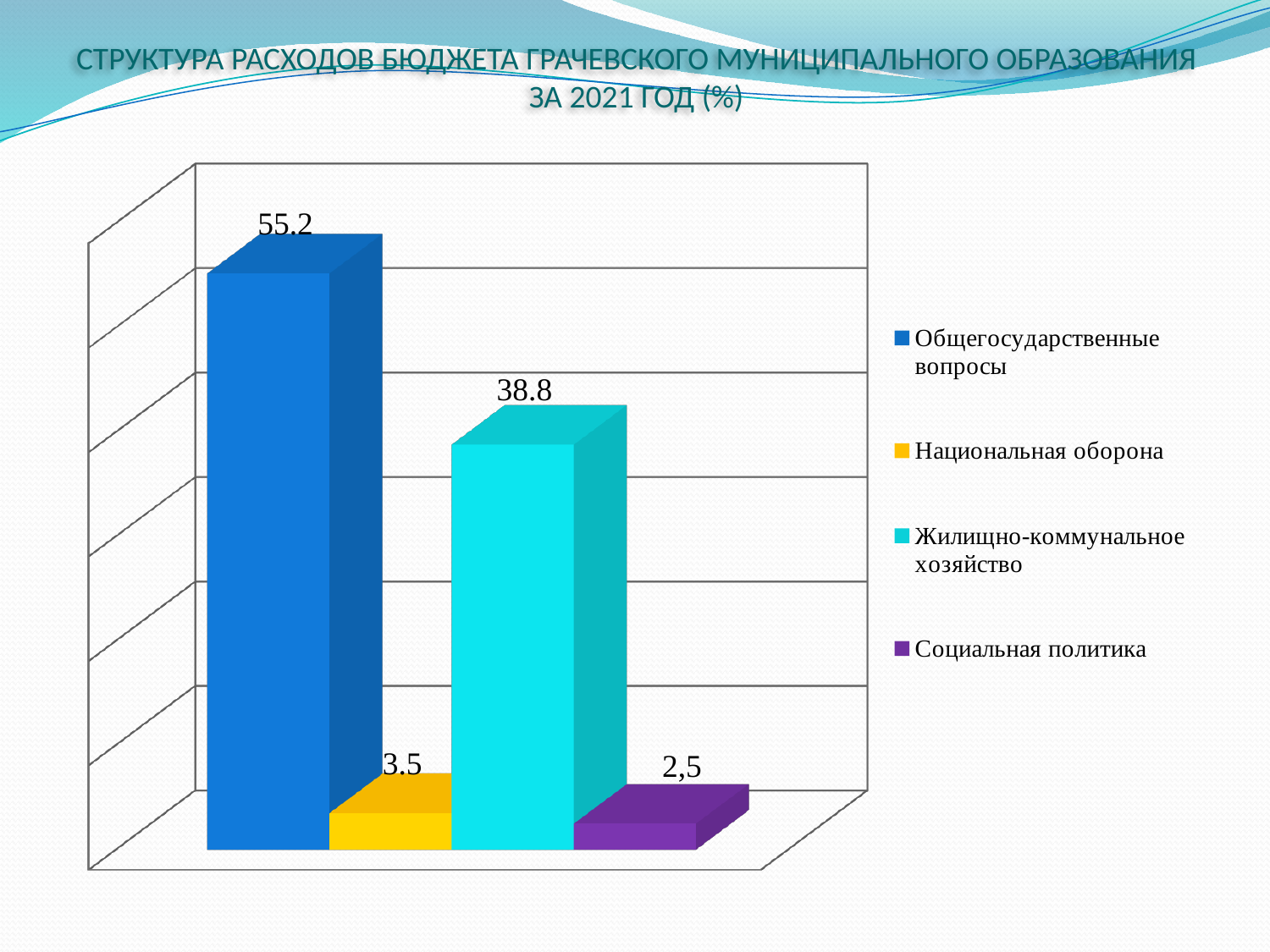
Which is larger, the value for Национальная оборона or the value for Социальная политика? Национальная оборона What is the difference between the values for Общегосударственные вопросы and Жилищно-коммунальное хозяйство? 16.4 Which legend entry is shown in purple? Социальная политика What is the value for Жилищно-коммунальное хозяйство? 38.8 What is the value for Общегосударственные вопросы? 55.2 How many bars are plotted on the chart? 4 Which category has the lowest value? Социальная политика Which category has the highest value? Общегосударственные вопросы What is the value for Социальная политика? 2,5 What is the value for Национальная оборона? 3.5 How many series does the legend list? 4 What kind of chart is shown on the slide? Bar chart